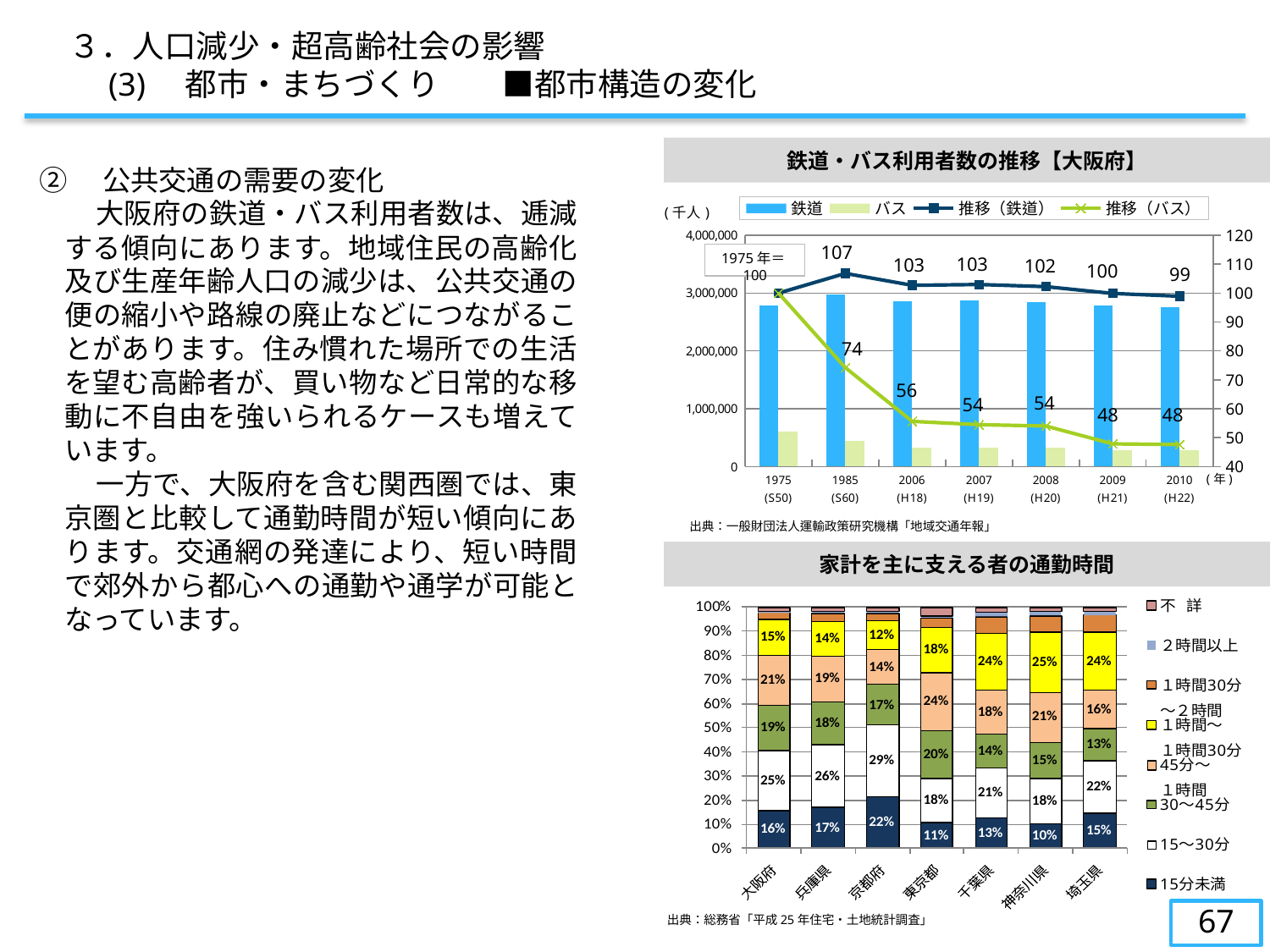
In the chart titled 家計を主に支える者の通勤時間, what is the share of 15分未満 for 京都府? 22% In the chart titled 鉄道・バス利用者数の推移【大阪府】, does 推移（バス） rise or fall from 1975 to 2010? fall In the chart titled 家計を主に支える者の通勤時間, which prefecture has the highest share of 15～30分? 京都府 In the chart titled 家計を主に支える者の通勤時間, what is the share of 1時間～1時間30分 for 神奈川県? 25% In the chart titled 家計を主に支える者の通勤時間, which is larger for 45分～1時間: 大阪府 or 東京都? 東京都 In the chart titled 鉄道・バス利用者数の推移【大阪府】, what is the value of 推移（バス） in 2010? 48 In the chart titled 鉄道・バス利用者数の推移【大阪府】, what is the difference between the 推移（バス） values for 1975 and 2010? 52 What kind of chart is the one titled 家計を主に支える者の通勤時間? stacked bar chart In the chart titled 鉄道・バス利用者数の推移【大阪府】, in which year is 推移（鉄道） highest? 1985 In the chart titled 鉄道・バス利用者数の推移【大阪府】, how many series does the legend list? 4 In the chart titled 鉄道・バス利用者数の推移【大阪府】, is the 鉄道 bar for 1985 greater or less than 2,000,000? greater In the chart titled 鉄道・バス利用者数の推移【大阪府】, what is the value of 推移（鉄道） in 1985? 107